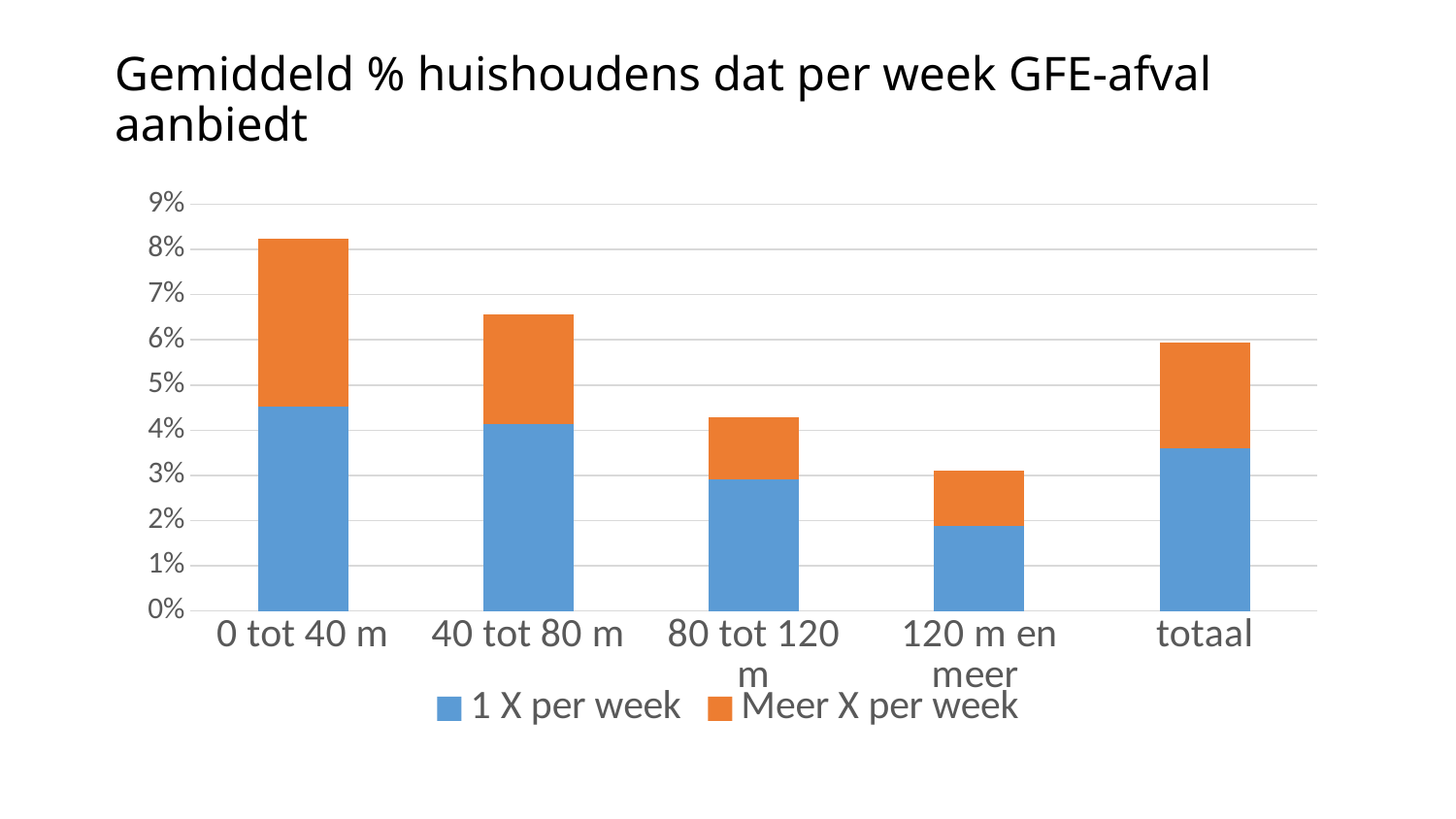
What kind of chart is shown on the slide? Stacked bar chart Is the total height of the stacked bar for '40 tot 80 m' greater or less than 6%? greater Which is larger: the '1 X per week' value for '40 tot 80 m' or for '80 tot 120 m'? 40 tot 80 m Which category has the tallest stacked bar? 0 tot 40 m Is the total height of the stacked bar for '120 m en meer' greater or less than 4%? less Is the value for '1 X per week' in the 'totaal' category greater or less than 3%? greater How many series does the legend list? 2 What are the two legend entries of the chart? 1 X per week; Meer X per week How many categories are shown on the x axis? 5 Across the distance categories from '0 tot 40 m' to '120 m en meer', do the stacked bar totals rise or fall? fall Which category has the shortest stacked bar? 120 m en meer